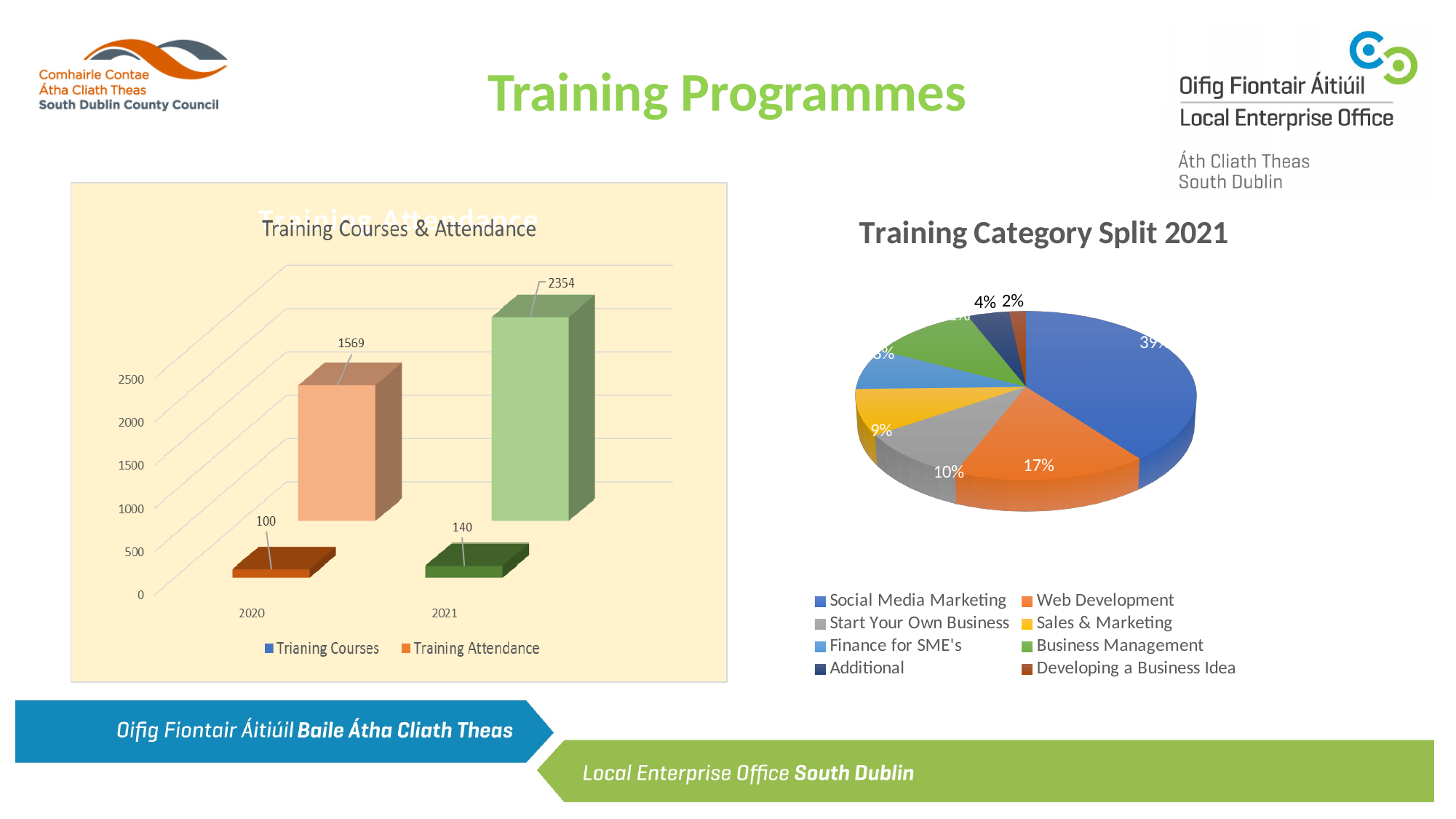
In the Training Courses & Attendance chart, which year has the higher Training Attendance? 2021 In the Training Category Split 2021 chart, what share does Web Development have? 17% In the Training Courses & Attendance chart, what is the Training Attendance value for 2021? 2354 What kind of chart is the Training Category Split 2021 chart? pie chart How many series does the legend of the Training Courses & Attendance chart list? 2 In the Training Courses & Attendance chart, what is the Training Attendance value for 2020? 1569 In the Training Courses & Attendance chart, by how much did Training Attendance increase from 2020 to 2021? 785 In the Training Courses & Attendance chart, what is the Trianing Courses value for 2021? 140 How many categories does the legend of the Training Category Split 2021 chart list? 8 In the Training Courses & Attendance chart, what is the Trianing Courses value for 2020? 100 In the Training Courses & Attendance chart, does Training Attendance rise or fall from 2020 to 2021? rise In the Training Category Split 2021 chart, what share does Start Your Own Business have? 10%